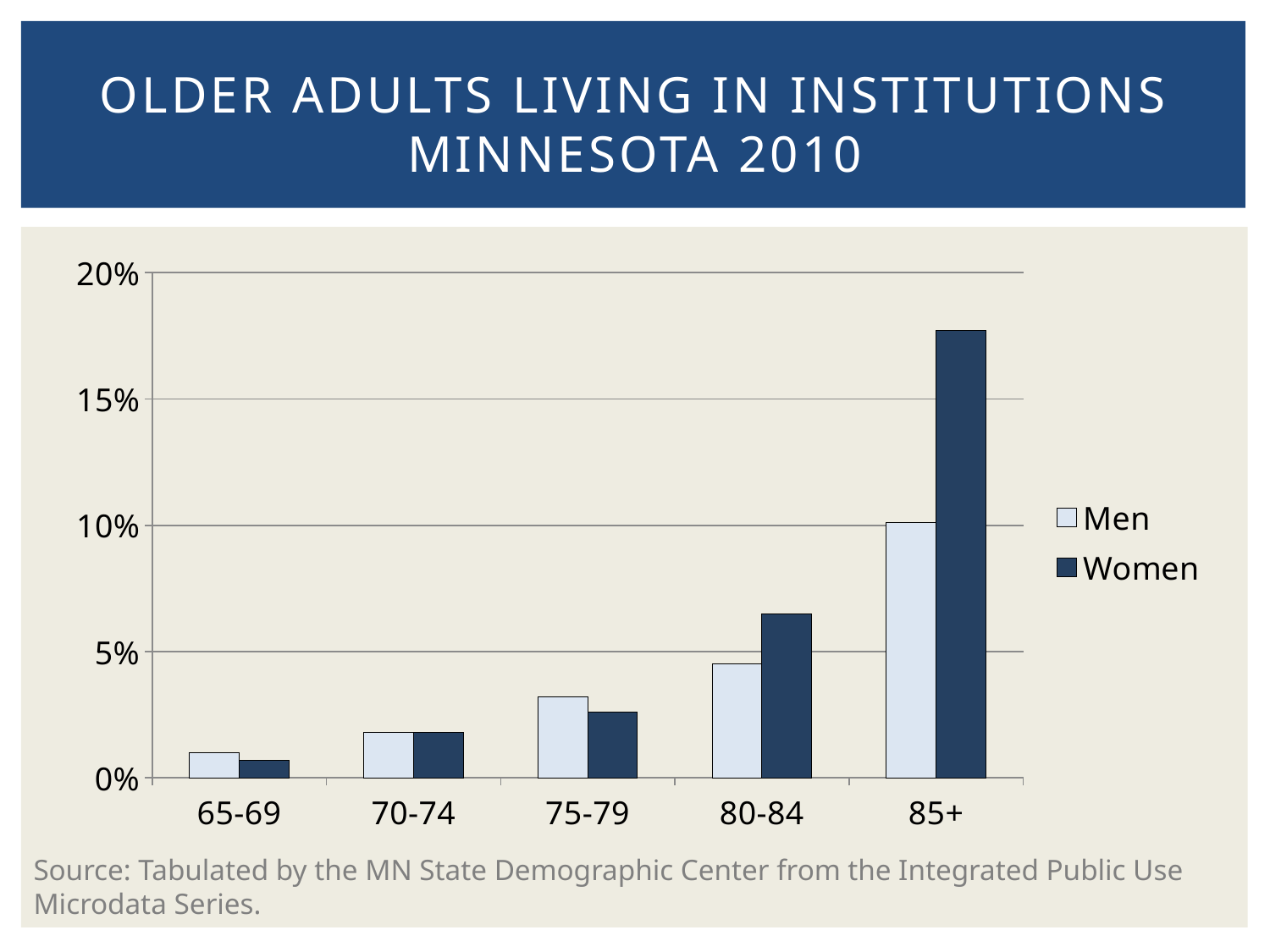
Which age group has the lowest value for Men? 65-69 Is the value for Men aged 80-84 greater or less than 5%? less Is the value for Women aged 80-84 greater or less than 5%? greater Which age group has the highest value for Women? 85+ What is the title of the chart? Older Adults Living in Institutions Minnesota 2010 How many series does the legend list? 2 Do the values for Women rise or fall as age increases along the x axis? rise How many age groups are shown on the x axis? 5 For the 85+ age group, which is larger, Men or Women? Women What kind of chart is shown on the slide? bar chart Is the value for Women aged 85+ greater or less than 15%? greater Which series are listed in the legend? Men and Women